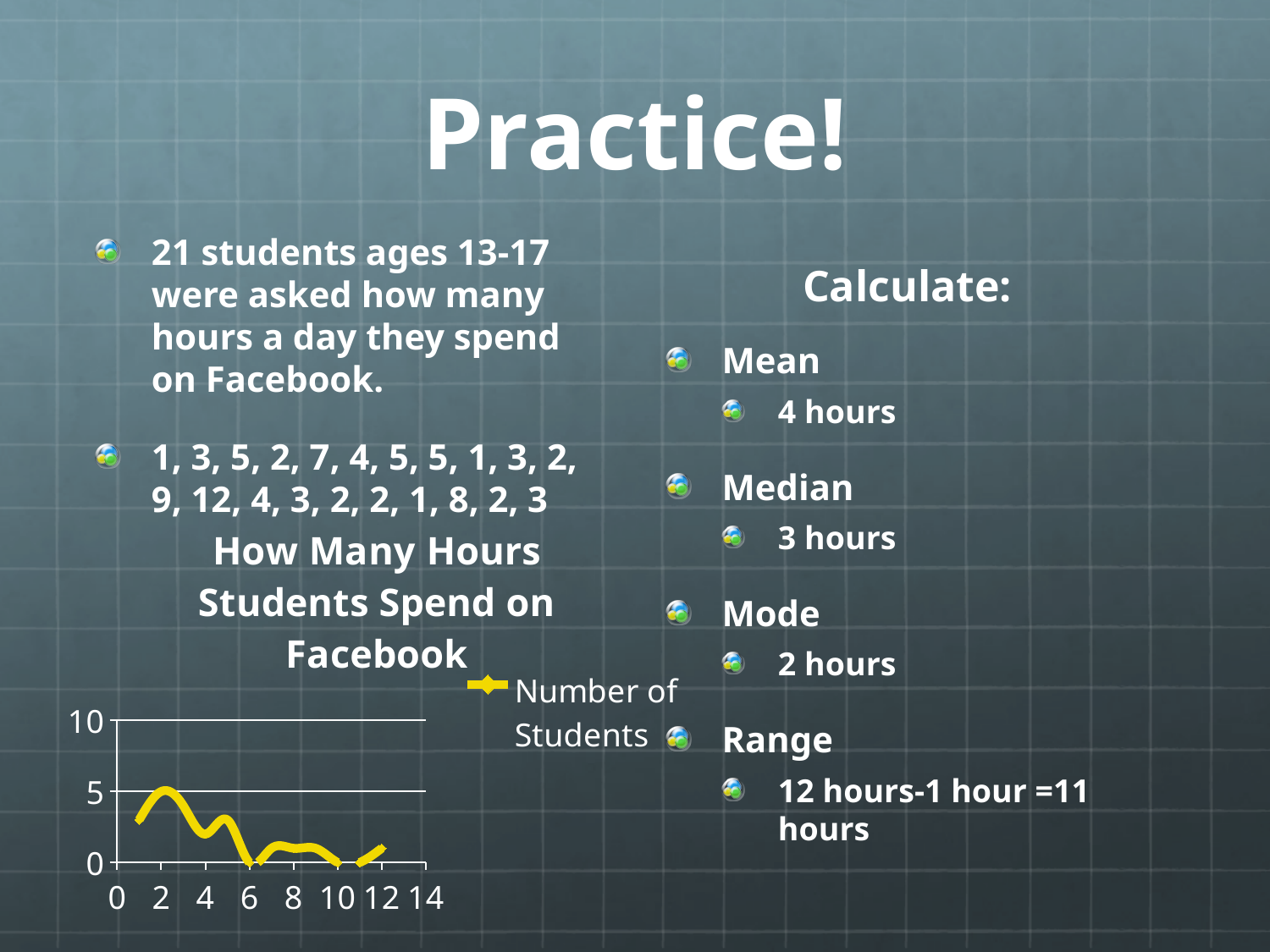
Is the value of the line at x = 12 greater or less than 5? less What kind of chart is shown on the slide? line chart What is the highest value shown on the chart's y-axis? 10 Is the value of the line at x = 6 greater or less than 5? less What is the title of the chart on the slide? How Many Hours Students Spend on Facebook At which x-axis value does the line reach its highest point? 2 How many series does the chart's legend list? 1 Is the value of the line at x = 8 greater or less than 5? less Do the values of the line generally rise or fall as the x-axis values increase from 2 to 12? fall What is the name of the series shown in the chart's legend? Number of Students Is the value of the line at x = 2 larger or smaller than the value at x = 8? larger